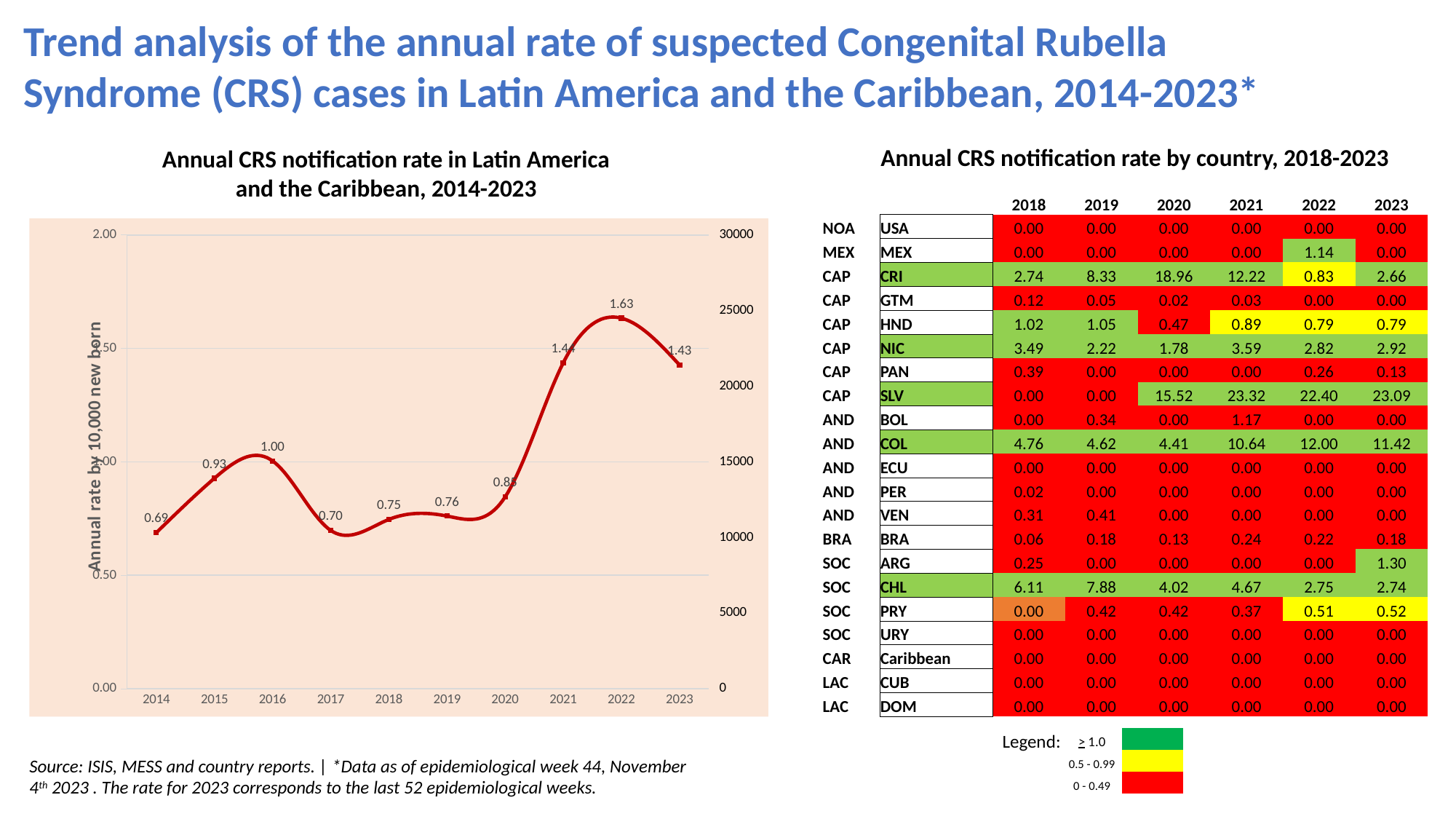
Which year has the larger annual CRS notification rate in the line chart, 2015 or 2017? 2015 What is the annual CRS notification rate for 2022 in the line chart? 1.63 What is the annual CRS notification rate for 2016 in the line chart? 1.00 Does the annual CRS notification rate rise or fall from 2014 to 2016 in the line chart? rise How many years are plotted on the x axis of the line chart? 10 By how much did the annual CRS notification rate fall from 2022 to 2023 in the line chart? 0.20 Which year has the lowest annual CRS notification rate in the line chart? 2014 What is the difference between the annual CRS notification rates for 2016 and 2017 in the line chart? 0.30 What kind of chart shows the annual CRS notification rate in Latin America and the Caribbean, 2014-2023? line chart Is the annual CRS notification rate for 2020 in the line chart greater or less than 1.00? less Which year has the highest annual CRS notification rate in the line chart? 2022 What is the annual CRS notification rate for 2014 in the line chart? 0.69